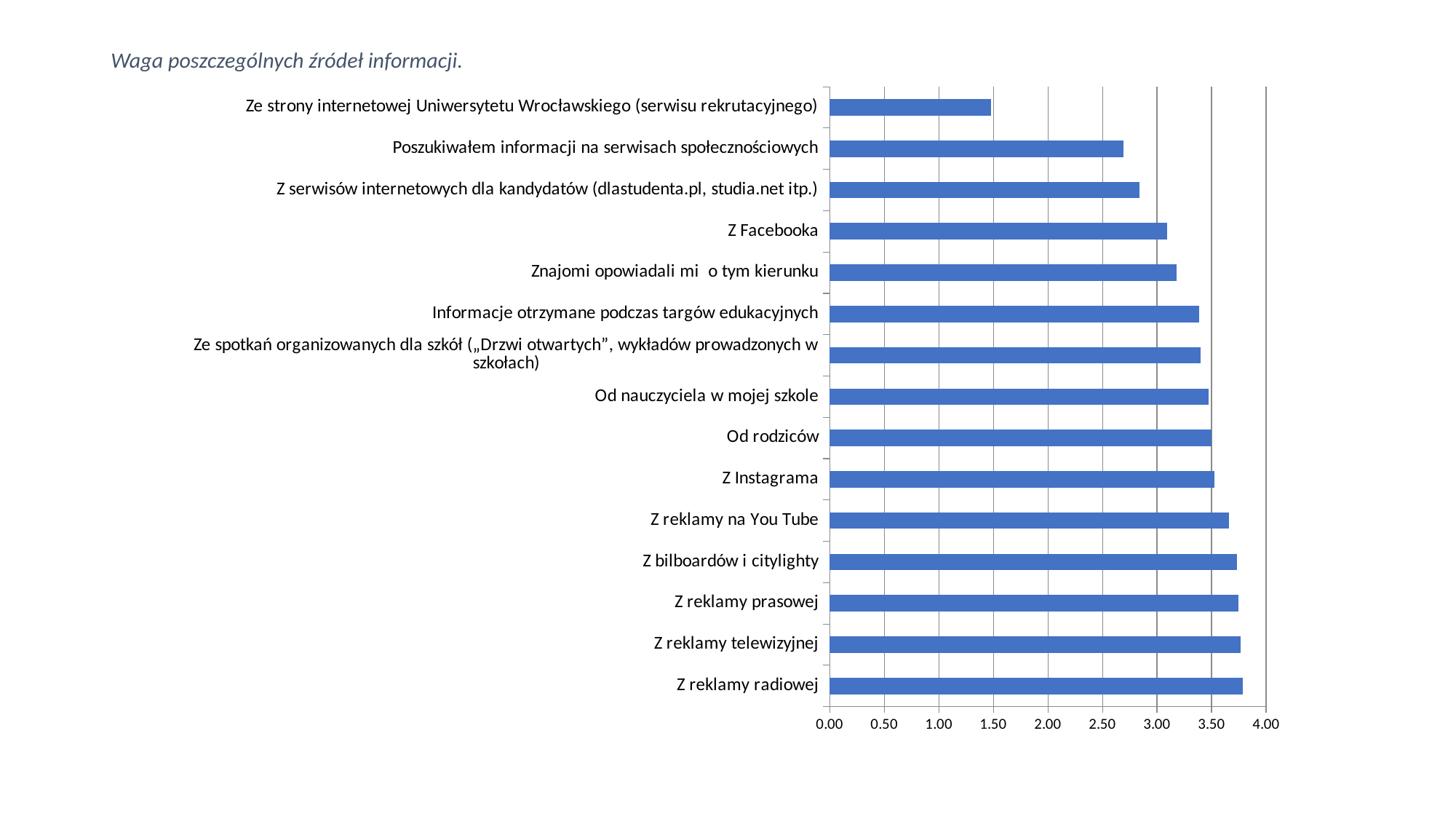
Is the value for 'Z reklamy telewizyjnej' greater or less than 3.50? greater Which has the larger value: 'Z serwisów internetowych dla kandydatów (dlastudenta.pl, studia.net itp.)' or 'Od rodziców'? Od rodziców How many categories (information sources) are plotted in the chart? 15 Is the value for 'Ze strony internetowej Uniwersytetu Wrocławskiego (serwisu rekrutacyjnego)' greater or less than 1.00? greater What is the title of the chart on the slide? Waga poszczególnych źródeł informacji. What kind of chart is shown on the slide? bar chart Which has the larger value: 'Z Facebooka' or 'Z reklamy radiowej'? Z reklamy radiowej Is the value for 'Poszukiwałem informacji na serwisach społecznościowych' greater or less than 2.50? greater Which has the larger value: 'Ze strony internetowej Uniwersytetu Wrocławskiego (serwisu rekrutacyjnego)' or 'Poszukiwałem informacji na serwisach społecznościowych'? Poszukiwałem informacji na serwisach społecznościowych Which category has the lowest value in the chart? Ze strony internetowej Uniwersytetu Wrocławskiego (serwisu rekrutacyjnego)